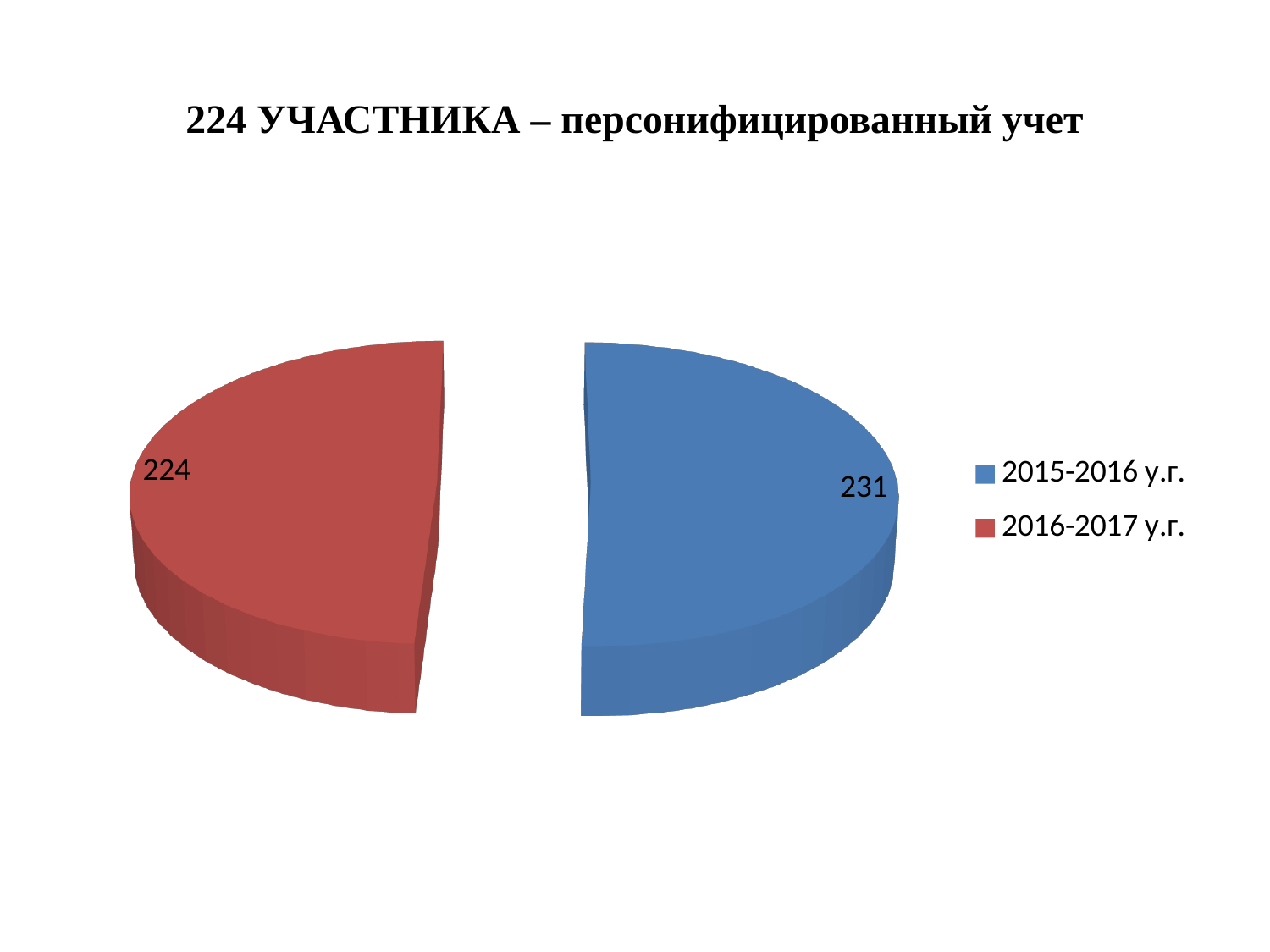
What type of chart is shown on the slide? Pie chart How many entries does the legend list? 2 Which category has the highest value? 2015-2016 у.г. What is the value for 2016-2017 у.г.? 224 What is the value for 2015-2016 у.г.? 231 Which category has the lowest value? 2016-2017 у.г. What is the total of the two slices in the pie chart? 455 Which is larger, the value for 2015-2016 у.г. or the value for 2016-2017 у.г.? 2015-2016 у.г. What colour is the slice for 2016-2017 у.г.? Red What is the title of the slide above the chart? 224 УЧАСТНИКА – персонифицированный учет What is the difference between the values for 2015-2016 у.г. and 2016-2017 у.г.? 7 How many slices does the pie chart have? 2